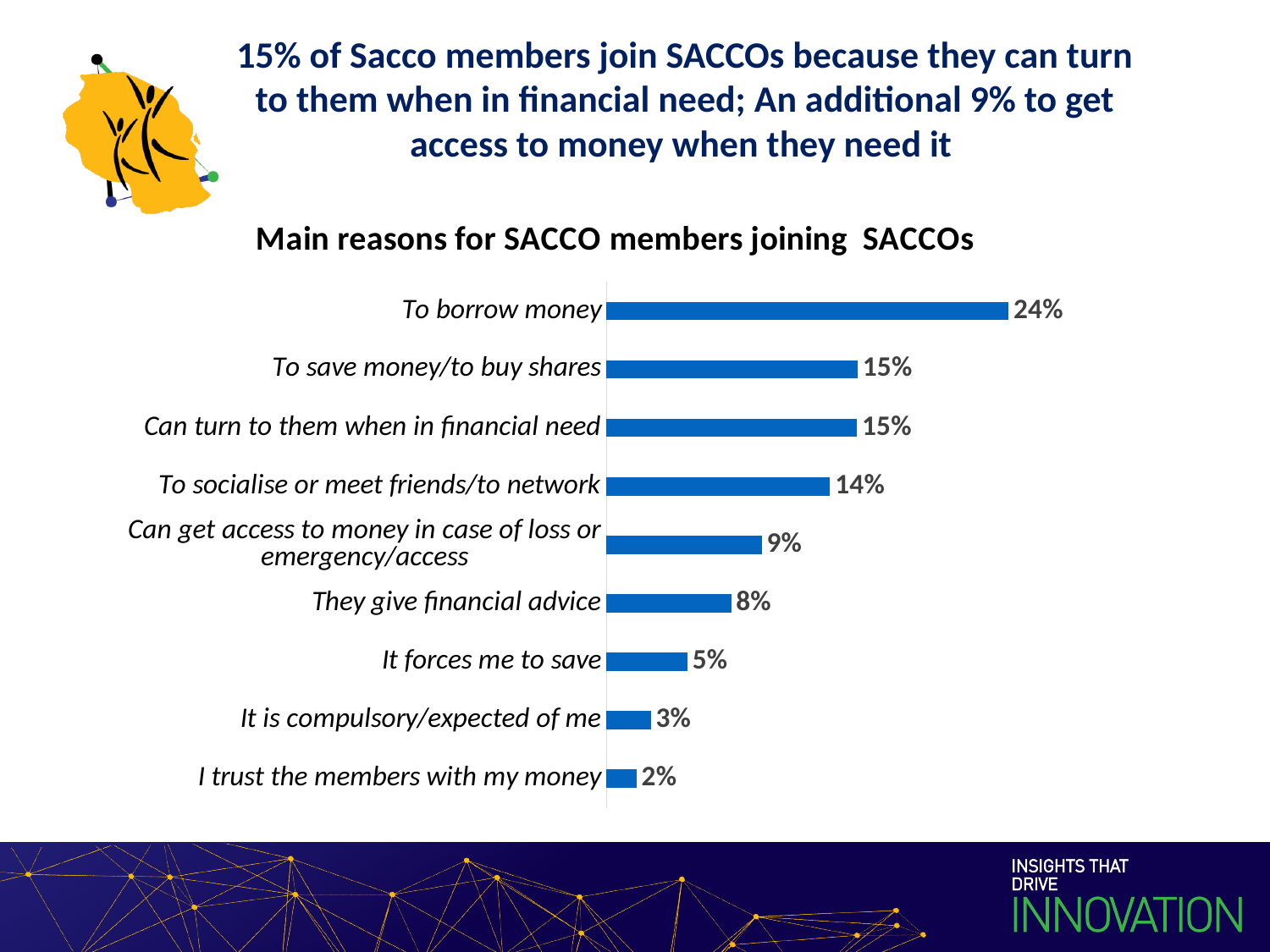
Which is larger: 'Can get access to money in case of loss or emergency/access' or 'They give financial advice'? Can get access to money in case of loss or emergency/access What is the difference between 'To socialise or meet friends/to network' and 'It is compulsory/expected of me'? 11% What is the title of the chart? Main reasons for SACCO members joining SACCOs What is the difference between 'To borrow money' and 'To save money/to buy shares'? 9% Which reason for joining SACCOs has the highest percentage? To borrow money What percentage of members join because it forces them to save? 5% Which reason for joining SACCOs has the lowest percentage? I trust the members with my money What percentage of SACCO members join to borrow money? 24% How many reasons for joining SACCOs are shown in the chart? 9 What type of chart is shown on the slide? Bar chart What is the value for 'They give financial advice'? 8% What colour are the bars in the chart? Blue